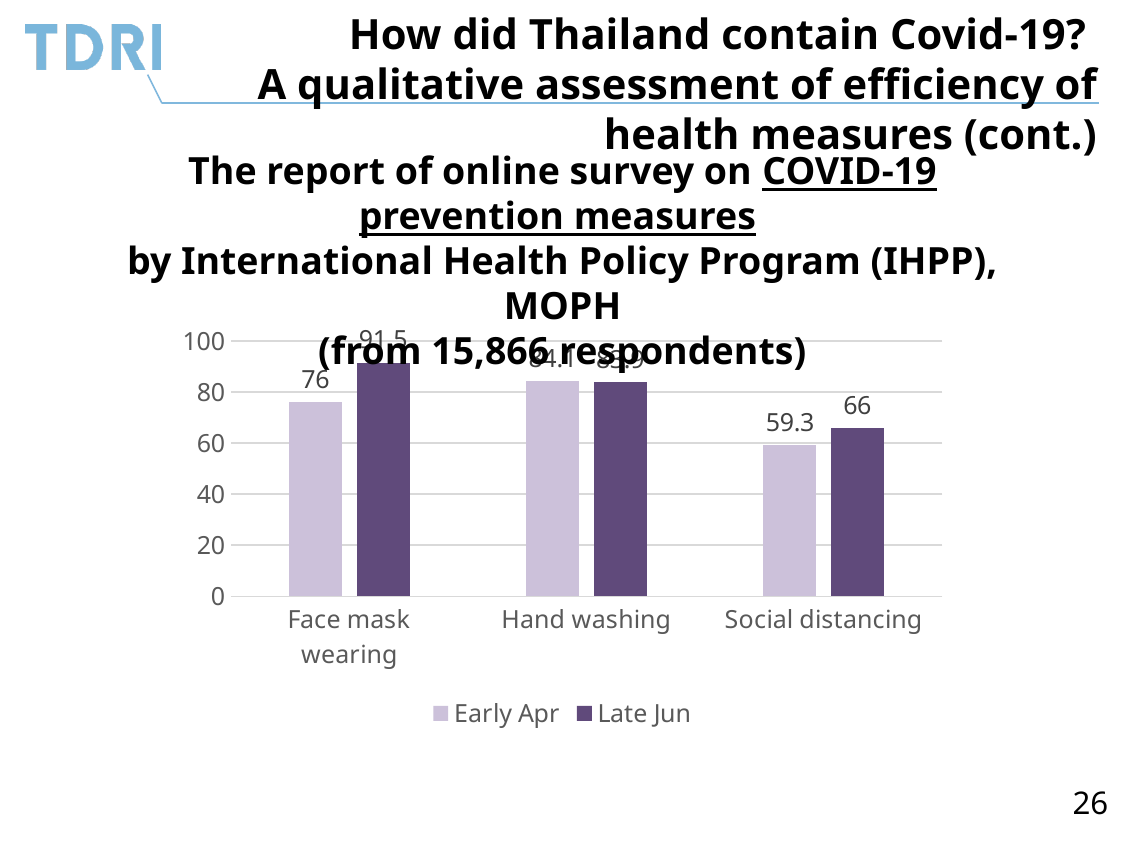
By how much did the Face mask wearing value increase from Early Apr to Late Jun? 15.5 Is the Early Apr value for Hand washing greater or less than 80? greater What is the difference between the Late Jun and Early Apr values for Social distancing? 6.7 Which category has the highest Late Jun value? Face mask wearing How many categories are shown on the x axis of the chart? 3 What is the Late Jun value for Social distancing? 66 What is the Late Jun value for Face mask wearing? 91.5 What is the Early Apr value for Face mask wearing? 76 Which category has the lowest Early Apr value? Social distancing What type of chart is shown on the slide? bar chart What is the Early Apr value for Social distancing? 59.3 How many series does the chart legend list? 2